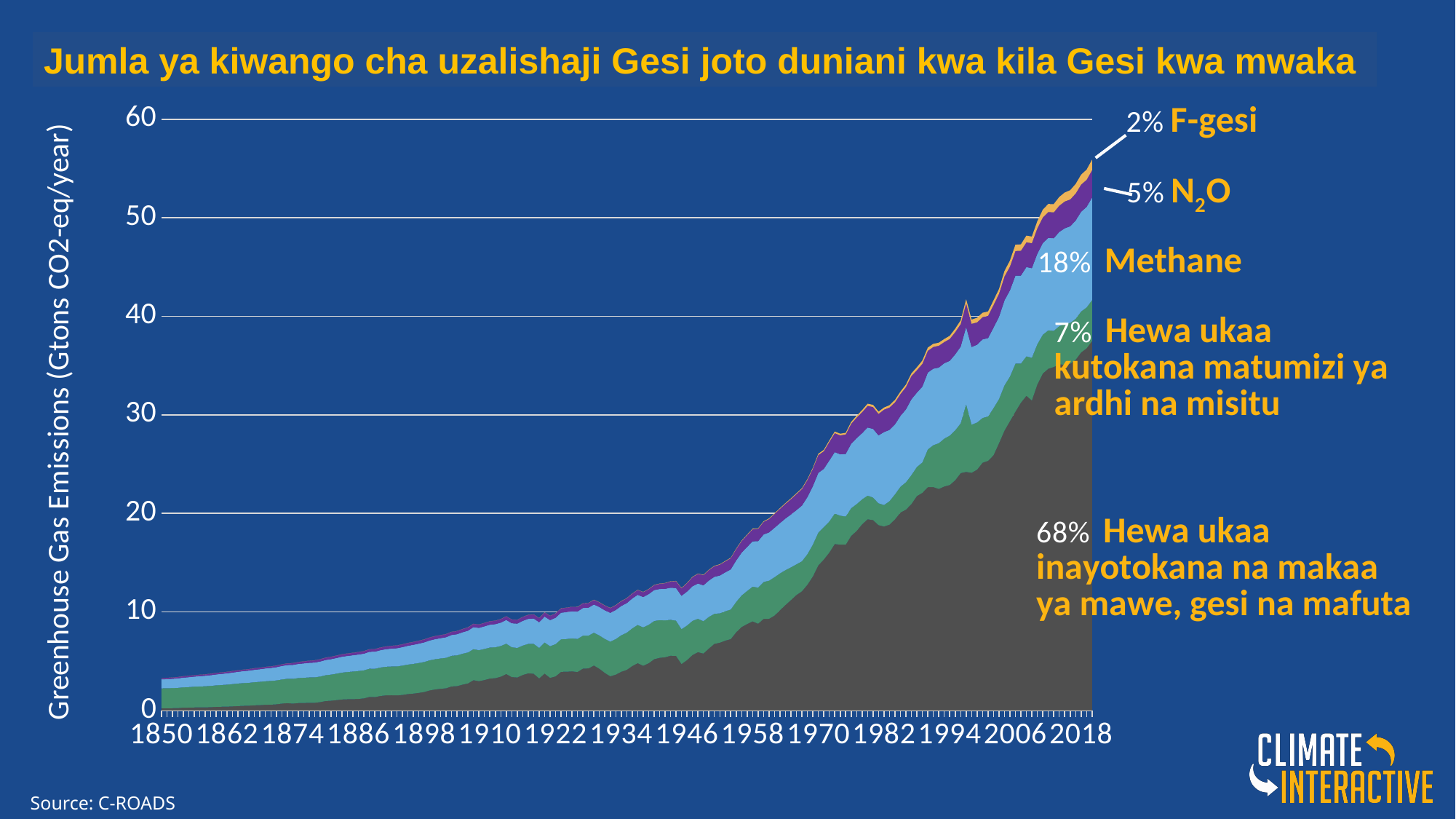
What share of emissions is attributed to F-gesi? 2% Which gas category has the largest share of emissions? Hewa ukaa inayotokana na makaa ya mawe, gesi na mafuta (68%) What share of emissions is attributed to 'Hewa ukaa kutokana matumizi ya ardhi na misitu'? 7% What share of emissions is attributed to N2O? 5% How many gas categories are stacked in the chart? 5 What share of emissions is attributed to Methane? 18% What kind of chart is shown on the slide? stacked area chart Do total greenhouse gas emissions rise or fall from 1850 to 2018? rise Which has a larger share, Methane or N2O? Methane Is the total emissions value in 2018 greater or less than 50 Gtons CO2-eq/year? greater What is the difference in percentage points between the share for fossil-fuel CO2 (68%) and Methane (18%)? 50 percentage points Which gas category has the smallest share of emissions? F-gesi (2%)